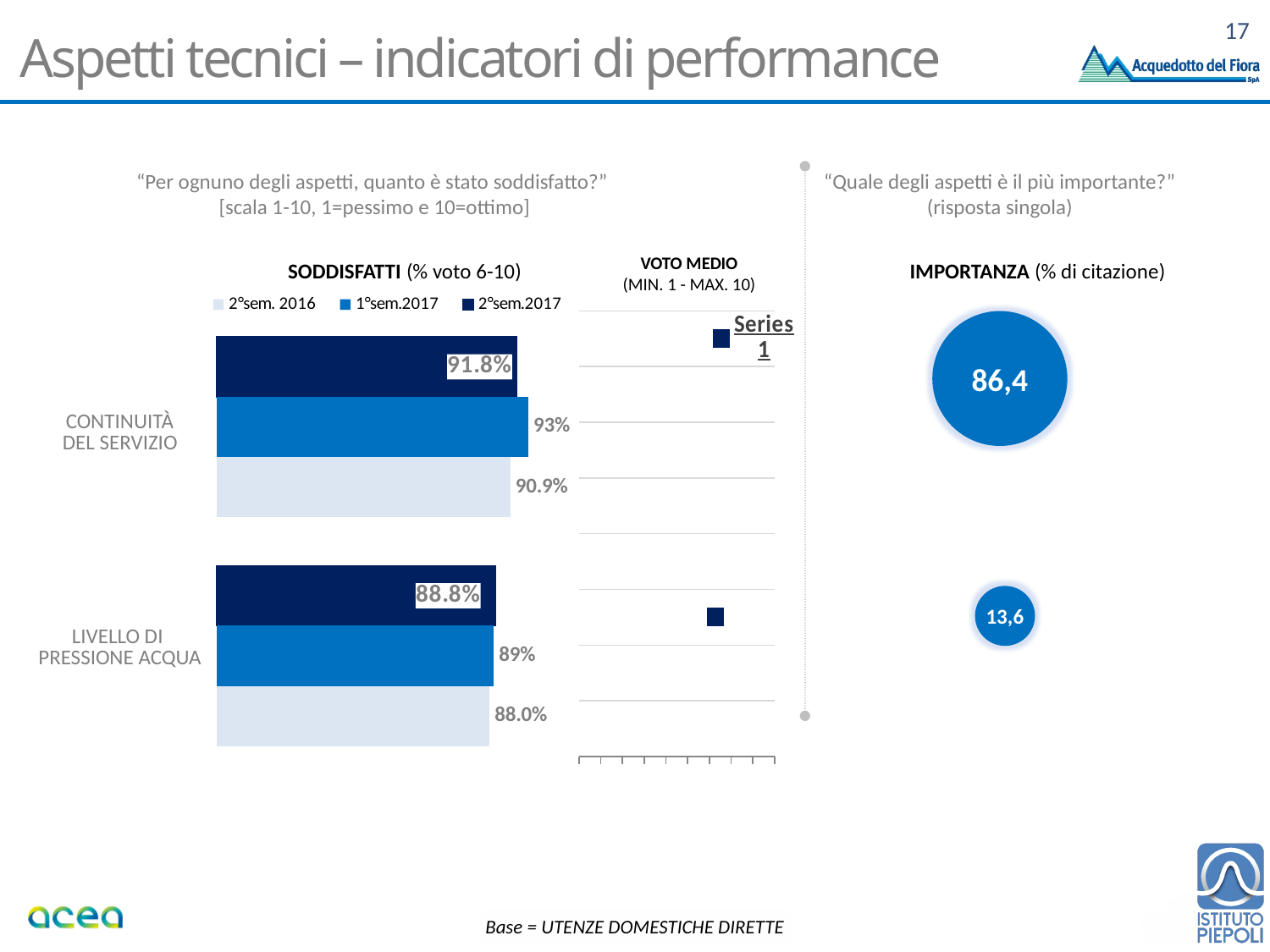
In the SODDISFATTI chart, what is the value for CONTINUITÀ DEL SERVIZIO in 2°sem.2017? 91.8% What kind of chart is the SODDISFATTI chart? Bar chart In the IMPORTANZA (% di citazione) chart, what is the value for CONTINUITÀ DEL SERVIZIO? 86,4 How many series does the legend of the SODDISFATTI chart list? 3 In the SODDISFATTI chart, what is the difference between the 1°sem.2017 and 2°sem. 2016 values for CONTINUITÀ DEL SERVIZIO? 2.1 percentage points In the SODDISFATTI chart, what is the value for LIVELLO DI PRESSIONE ACQUA in 2°sem.2017? 88.8% In the IMPORTANZA (% di citazione) chart, what is the value for LIVELLO DI PRESSIONE ACQUA? 13,6 In the SODDISFATTI chart, what is the value for CONTINUITÀ DEL SERVIZIO in 1°sem.2017? 93% In the SODDISFATTI chart, what is the value for LIVELLO DI PRESSIONE ACQUA in 2°sem. 2016? 88.0% How many categories are shown in the SODDISFATTI chart? 2 In the SODDISFATTI chart, which category has the highest value in 1°sem.2017? CONTINUITÀ DEL SERVIZIO In the SODDISFATTI chart, which is larger for LIVELLO DI PRESSIONE ACQUA: the 1°sem.2017 value or the 2°sem.2017 value? 1°sem.2017